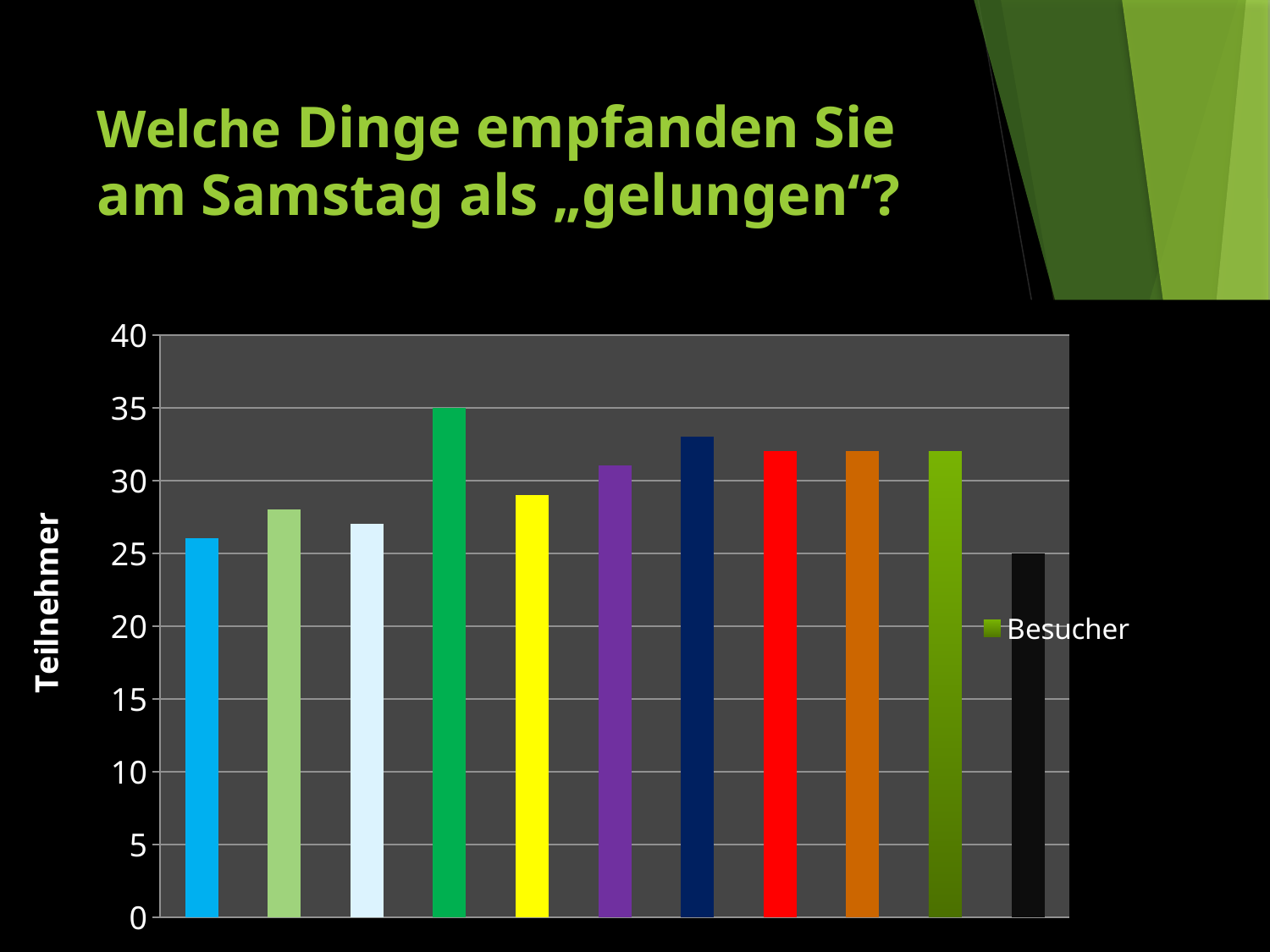
Is the value of the first (light blue) bar greater or less than 30? less Which bar is the tallest in the chart? the fourth (green) bar Is the value of the last (black) bar greater or less than 30? less Which bar is the shortest in the chart? the last (black) bar What value does the tallest (green, fourth) bar reach? 35 Is the value of the seventh (dark blue) bar greater or less than 30? greater What is the legend entry of the chart? Besucher How many bars are plotted in the chart? 11 Which is larger, the fourth (green) bar or the fifth (yellow) bar? the fourth (green) bar What is the title of the vertical axis? Teilnehmer What kind of chart is shown on the slide? bar chart How many series does the legend list? 1